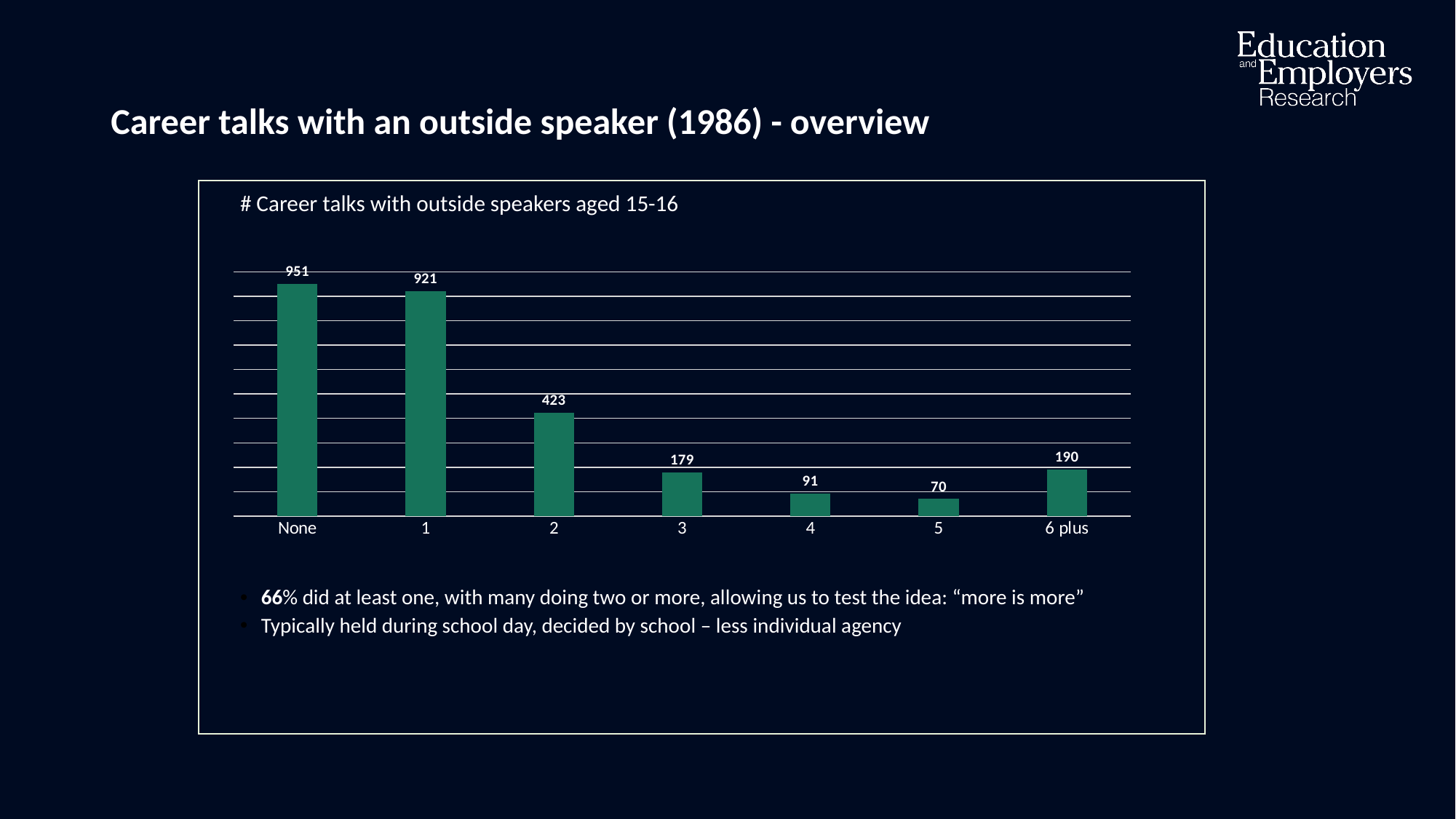
What is the value for the 'None' category? 951 Which category has the lowest value? 5 What kind of chart is shown on the slide? Bar chart Do the values generally rise or fall from 'None' to '5'? Fall What is the value for the '2' category? 423 What is the title of the chart? # Career talks with outside speakers aged 15-16 What is the difference between the values for 'None' and '1'? 30 Which is larger, the value for '4' or the value for '6 plus'? 6 plus How many categories are shown on the x axis? 7 Which category has the highest value? None What is the value for the '6 plus' category? 190 What is the difference between the values for '2' and '3'? 244